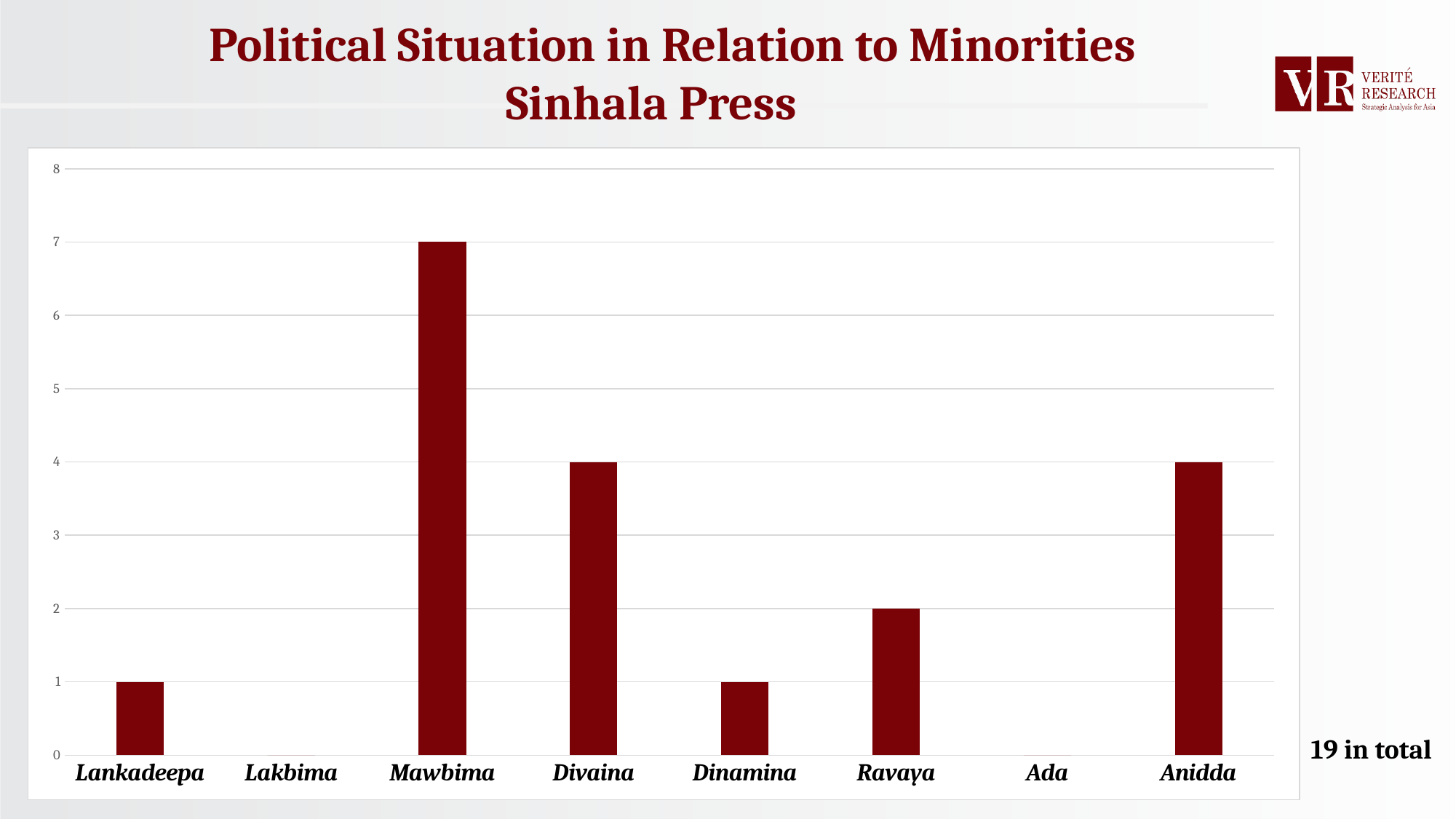
What is the value for Ravaya? 2 What is the total number of items across all newspapers, as stated on the slide? 19 in total What is the value for Divaina? 4 What kind of chart is shown on the slide? bar chart Which is larger, the value for Ravaya or the value for Dinamina? Ravaya What is the value for Mawbima? 7 What colour are the bars in the chart? dark red Is the value for Mawbima greater or less than 5? greater How many newspapers are shown on the x axis? 8 What is the difference between the values for Mawbima and Anidda? 3 Which newspaper has the highest value? Mawbima What is the title of the chart? Political Situation in Relation to Minorities Sinhala Press